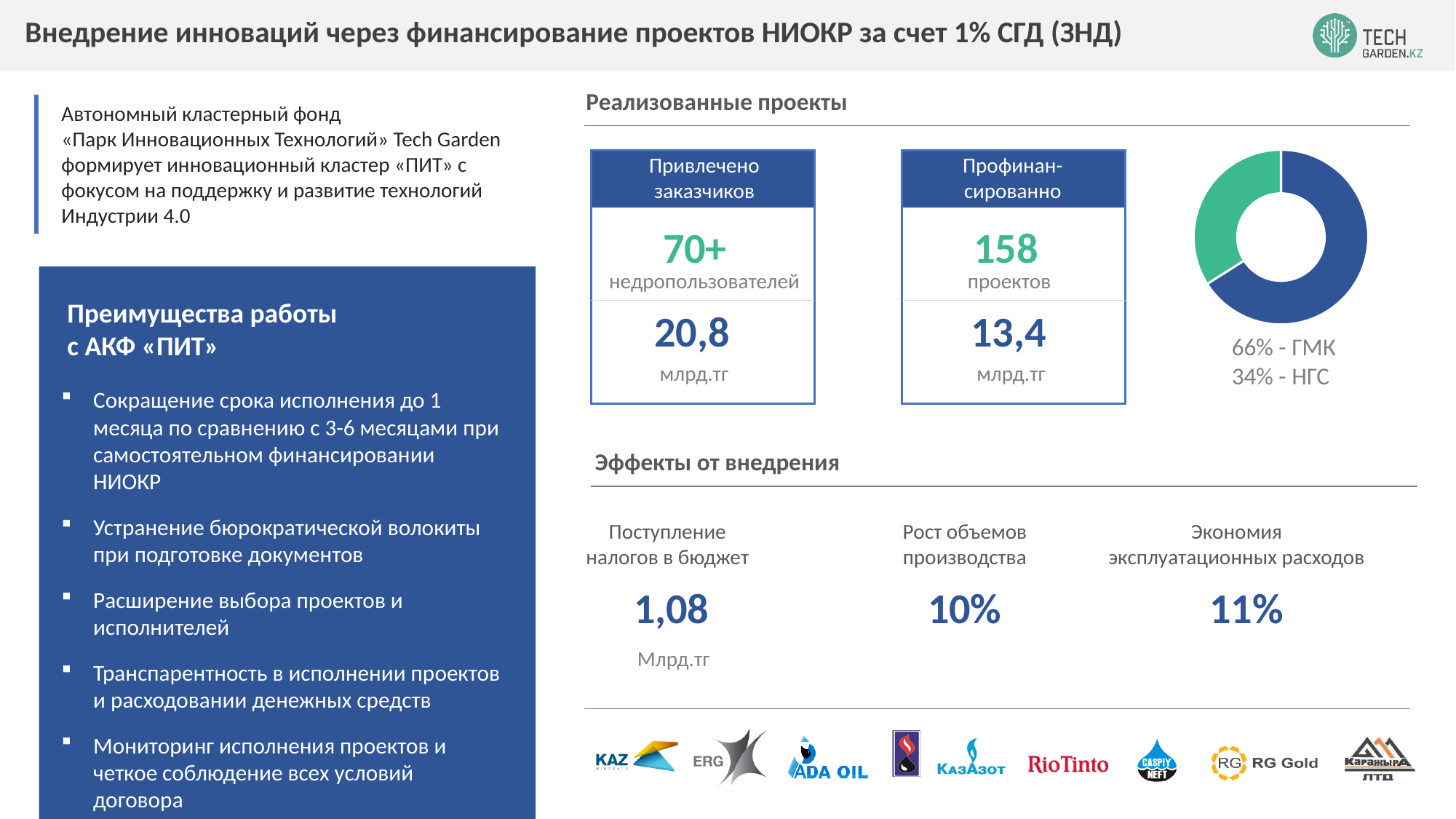
What colour is the ГМК slice in the donut chart? Blue What share of the donut chart does НГС account for? 34% By how many percentage points does the ГМК share exceed the НГС share in the donut chart? 32 Which category has the largest slice in the donut chart? ГМК What colour is the НГС slice in the donut chart? Green Which category has the smallest slice in the donut chart? НГС What kind of chart is shown in the "Реализованные проекты" section? Pie (donut) chart How many slices does the donut chart have? 2 What is the combined share of ГМК and НГС in the donut chart? 100% What share of the donut chart does ГМК account for? 66% In the donut chart, which is larger: ГМК or НГС? ГМК